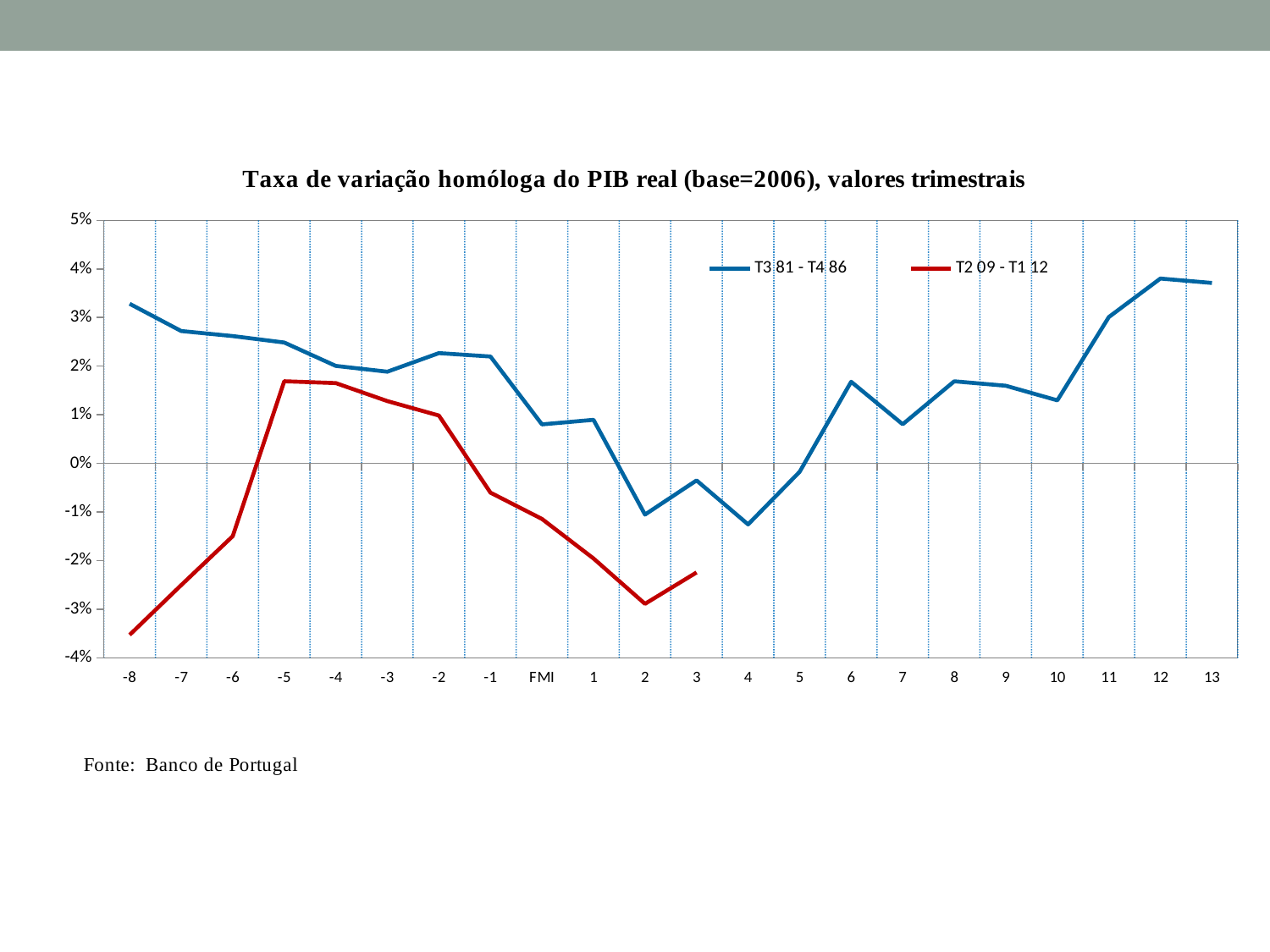
How many series does the legend list? 2 Does the T2 09 - T1 12 series rise or fall between -8 and -5? rise What colour is the line for the T2 09 - T1 12 series? Red Is the value of the T2 09 - T1 12 series at 2 greater or less than -2%? less Does the T2 09 - T1 12 series rise or fall between -5 and 2? fall At -5, which series has the higher value, T3 81 - T4 86 or T2 09 - T1 12? T3 81 - T4 86 At which x-axis point does the T2 09 - T1 12 series reach its lowest value? -8 Is the value of the T2 09 - T1 12 series at -8 greater or less than -3%? less Is the value of the T3 81 - T4 86 series at 6 greater or less than 1%? greater How many points are labelled along the x axis (from -8 to 13)? 22 What kind of chart is shown on the slide? Line chart